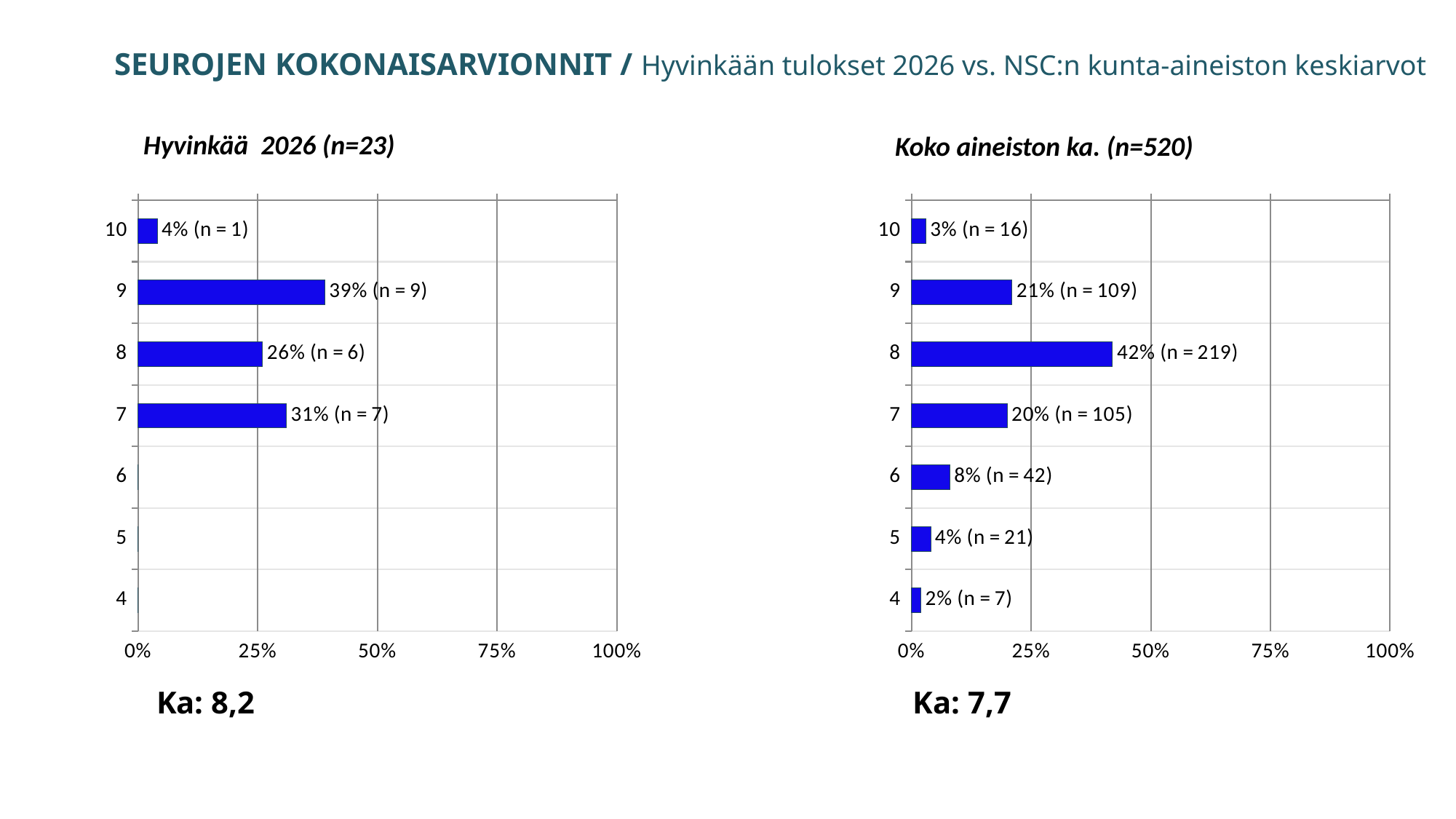
In the 'Hyvinkää 2026 (n=23)' chart, what percentage is shown for rating 9? 39% What average (Ka) is shown below the 'Hyvinkää 2026 (n=23)' chart? 8,2 In the 'Koko aineiston ka. (n=520)' chart, what percentage is shown for rating 8? 42% In the 'Koko aineiston ka. (n=520)' chart, is the value for rating 8 greater or less than 25%? greater What type of chart is the 'Koko aineiston ka. (n=520)' chart? bar chart In the 'Koko aineiston ka. (n=520)' chart, which has a larger percentage: rating 9 or rating 7? 9 In the 'Hyvinkää 2026 (n=23)' chart, how many respondents (n) gave a rating of 7? 7 In the 'Hyvinkää 2026 (n=23)' chart, what is the difference in percentage points between rating 9 and rating 8? 13 In the 'Koko aineiston ka. (n=520)' chart, how many respondents (n) gave a rating of 6? 42 In the 'Hyvinkää 2026 (n=23)' chart, which rating has the highest percentage? 9 How many rating categories are listed on the vertical axis of the 'Hyvinkää 2026 (n=23)' chart? 7 In the 'Koko aineiston ka. (n=520)' chart, which rating has the lowest percentage? 4